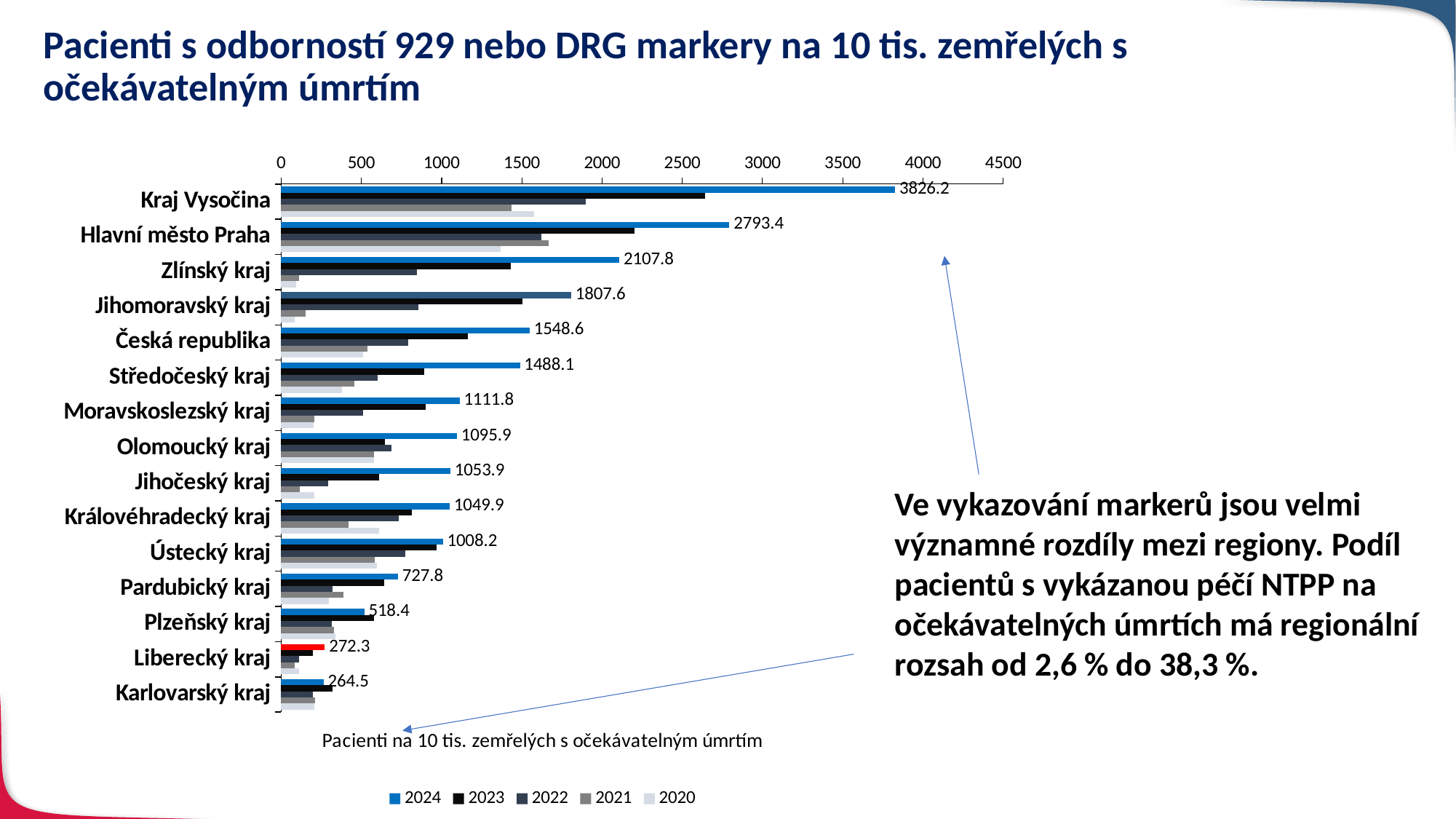
How many regions (categories) are plotted on the chart? 15 What kind of chart is shown on the slide? bar chart Which region's 2024 bar is highlighted in red? Liberecký kraj Is the 2023 value for Středočeský kraj greater or less than 1000? less Which has the larger 2024 value, Pardubický kraj or Plzeňský kraj? Pardubický kraj What is the 2024 value for Ústecký kraj? 1008.2 What is the difference between the 2024 values of Kraj Vysočina and Hlavní město Praha? 1032.8 Which region has the lowest 2024 value? Karlovarský kraj Which region has the highest 2024 value? Kraj Vysočina What is the 2024 value for Zlínský kraj? 2107.8 How many series does the legend list? 5 What is the 2024 value for Česká republika? 1548.6